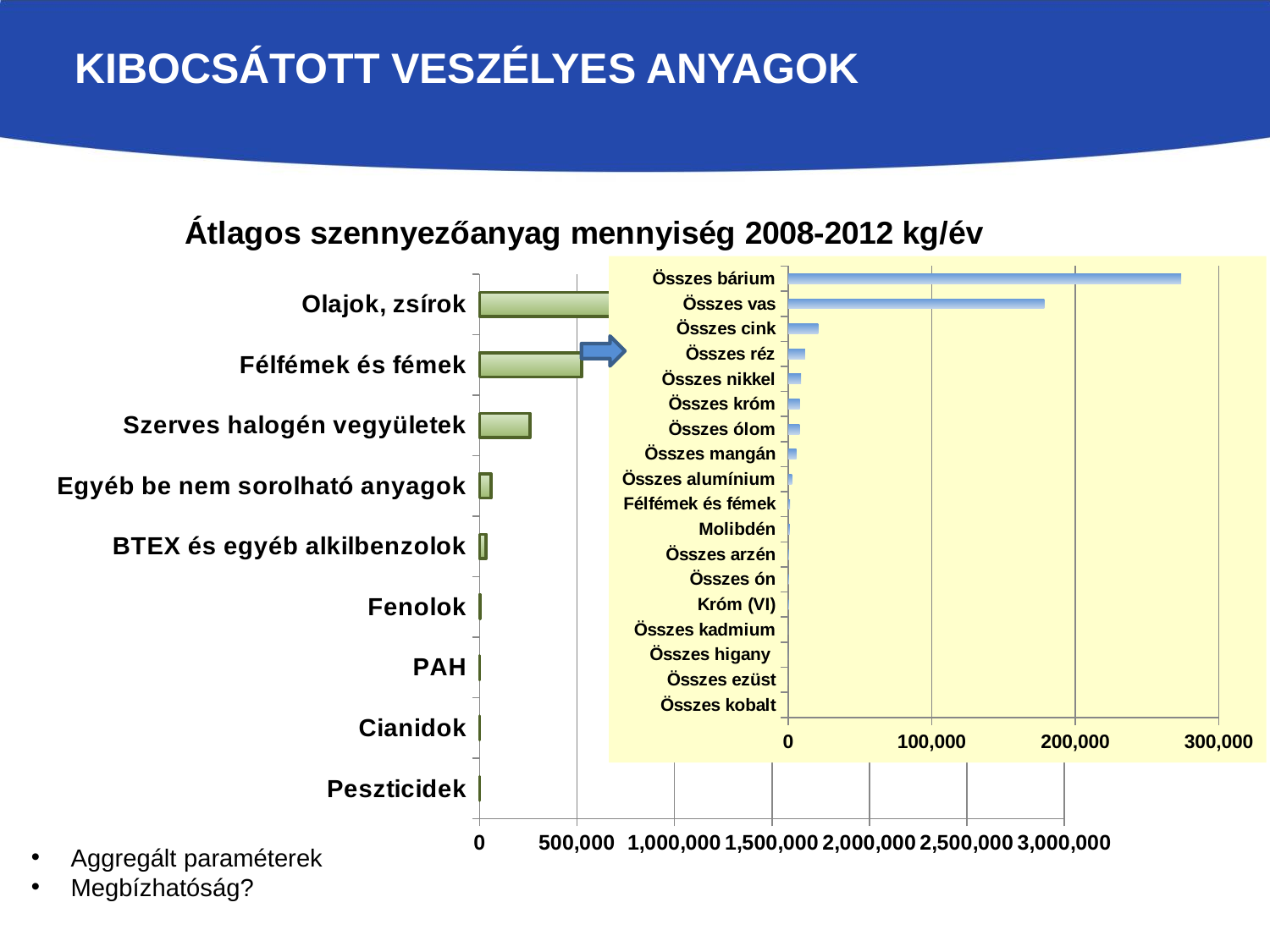
In the inset chart on the right, is the value for Összes vas greater or less than 200,000? less In the main chart 'Átlagos szennyezőanyag mennyiség 2008-2012 kg/év', which is larger: Szerves halogén vegyületek or Egyéb be nem sorolható anyagok? Szerves halogén vegyületek In the main chart 'Átlagos szennyezőanyag mennyiség 2008-2012 kg/év', is the value for Szerves halogén vegyületek greater or less than 500,000? less What is the title of the main chart on the slide? Átlagos szennyezőanyag mennyiség 2008-2012 kg/év In the inset chart on the right, which category has the highest value? Összes bárium In the inset chart on the right (starting with Összes bárium), how many categories are plotted? 18 In the inset chart on the right, is the value for Összes bárium greater or less than 200,000? greater What kind of chart is the main chart titled 'Átlagos szennyezőanyag mennyiség 2008-2012 kg/év'? bar chart In the main chart 'Átlagos szennyezőanyag mennyiség 2008-2012 kg/év', how many categories are plotted? 9 In the inset chart on the right, which is larger: Összes vas or Összes cink? Összes vas In the main chart 'Átlagos szennyezőanyag mennyiség 2008-2012 kg/év', which category has the highest value? Olajok, zsírok